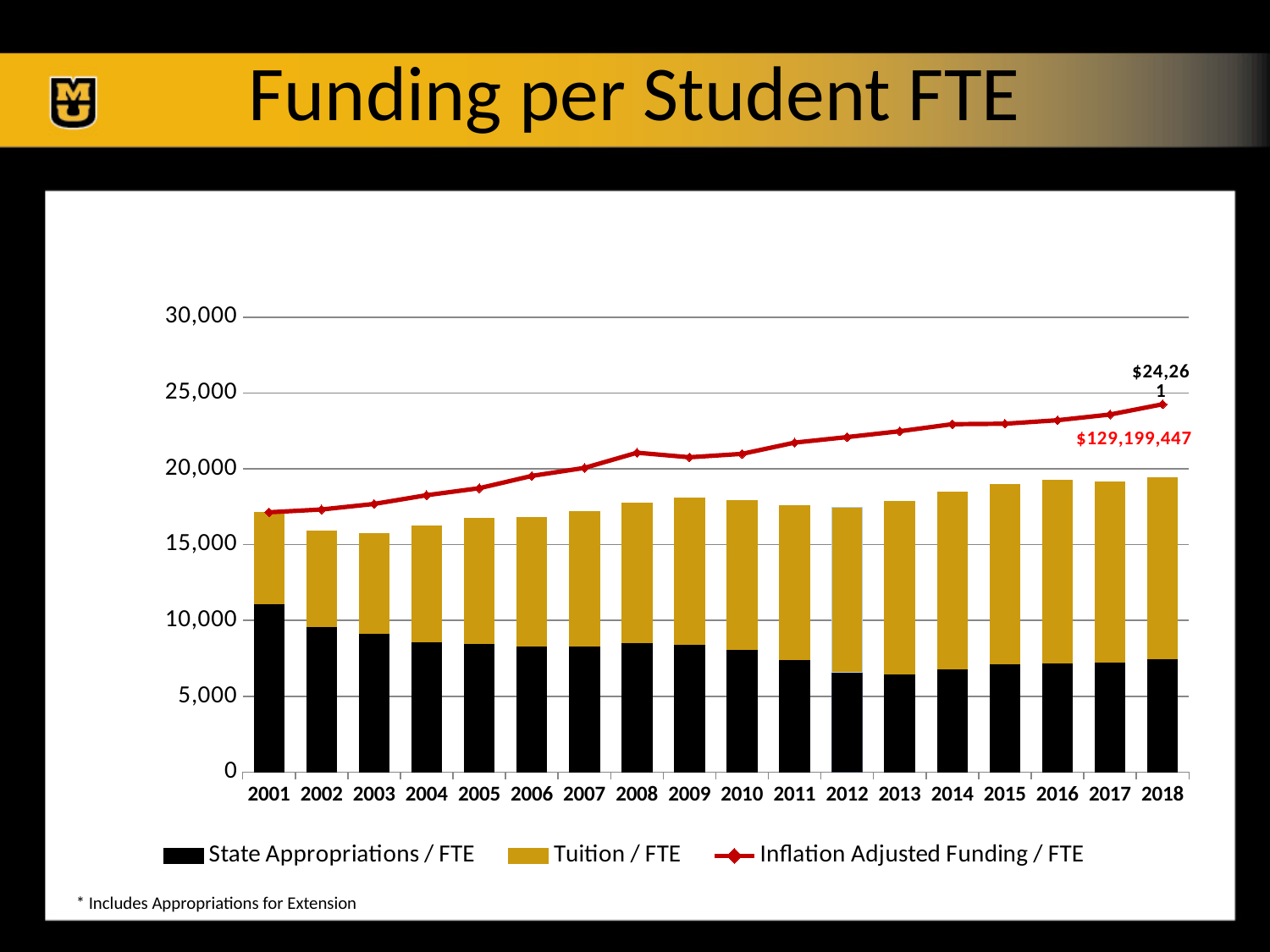
Is the value of State Appropriations / FTE for 2012 greater or less than 10,000? less How many series does the legend list? 3 Is the Inflation Adjusted Funding / FTE for 2008 greater or less than 20,000? greater Which year has the highest Inflation Adjusted Funding / FTE? 2018 Is the Inflation Adjusted Funding / FTE for 2001 greater or less than 20,000? less Which year has the highest State Appropriations / FTE? 2001 Which year has the larger State Appropriations / FTE, 2001 or 2018? 2001 How many years are shown on the x axis? 18 What is the labelled value of Inflation Adjusted Funding / FTE for 2018? $24,261 What kind of chart is shown on the slide? Stacked bar chart with a line Does the Inflation Adjusted Funding / FTE line rise or fall from 2001 to 2018? rise